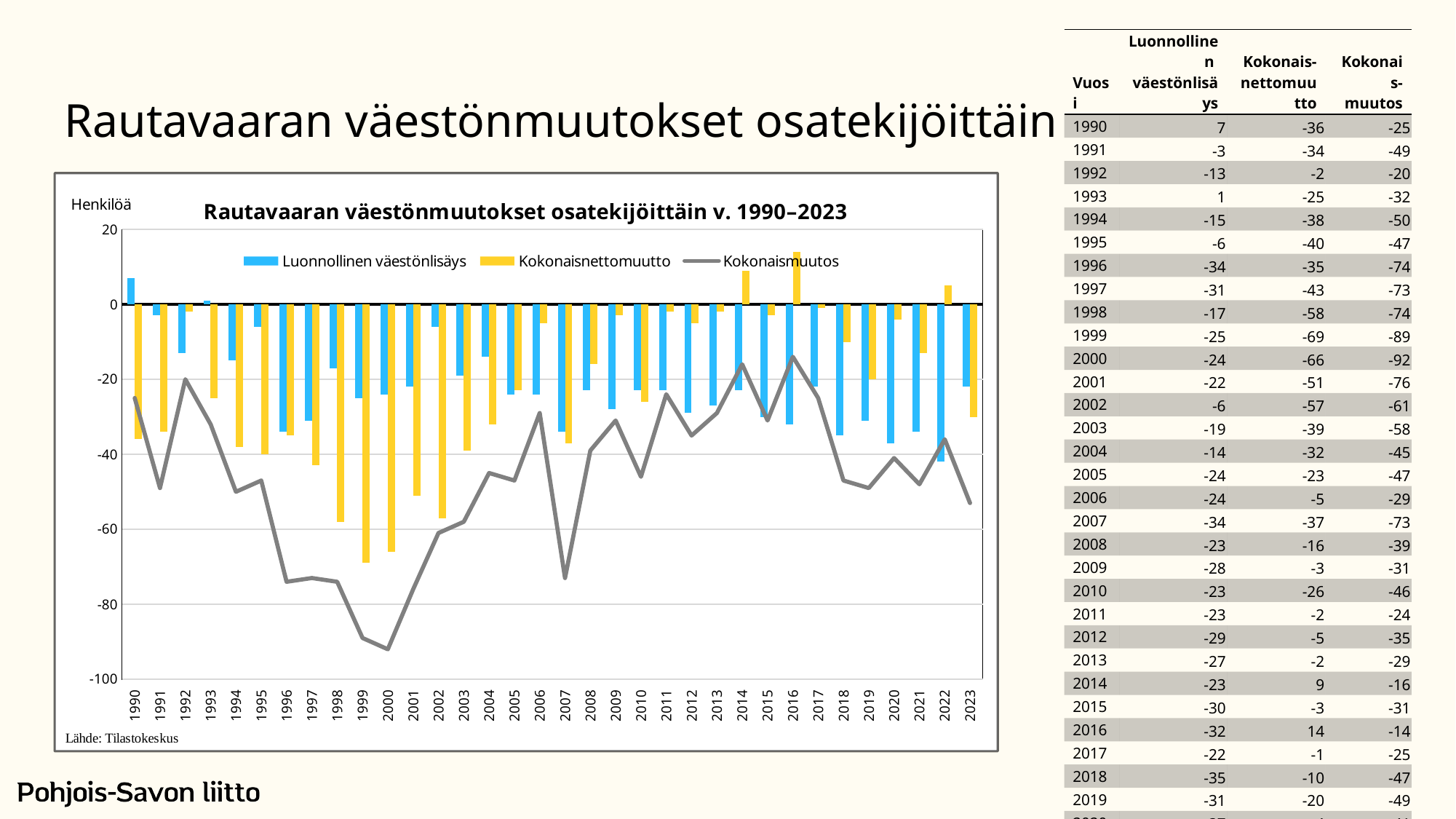
Does the Kokonaismuutos line generally rise or fall from 1990 to 2000? fall In which year is the Kokonaismuutos line at its lowest? 2000 How many series does the chart legend list? 3 What kind of chart is shown on the slide? combined bar and line chart In which year is the Kokonaisnettomuutto bar the highest? 2016 What is the Luonnollinen väestönlisäys value for 1990? 7 What is the title of the chart? Rautavaaran väestönmuutokset osatekijöittäin v. 1990–2023 How many years are shown on the x axis of the chart? 34 What is the difference between the Kokonaismuutos values for 1990 and 1991? 24 Is the Kokonaismuutos value for 1999 greater or less than -80? less What is the Kokonaismuutos value for the year 2000? -92 Which year has the larger Luonnollinen väestönlisäys value, 1992 or 1996? 1992